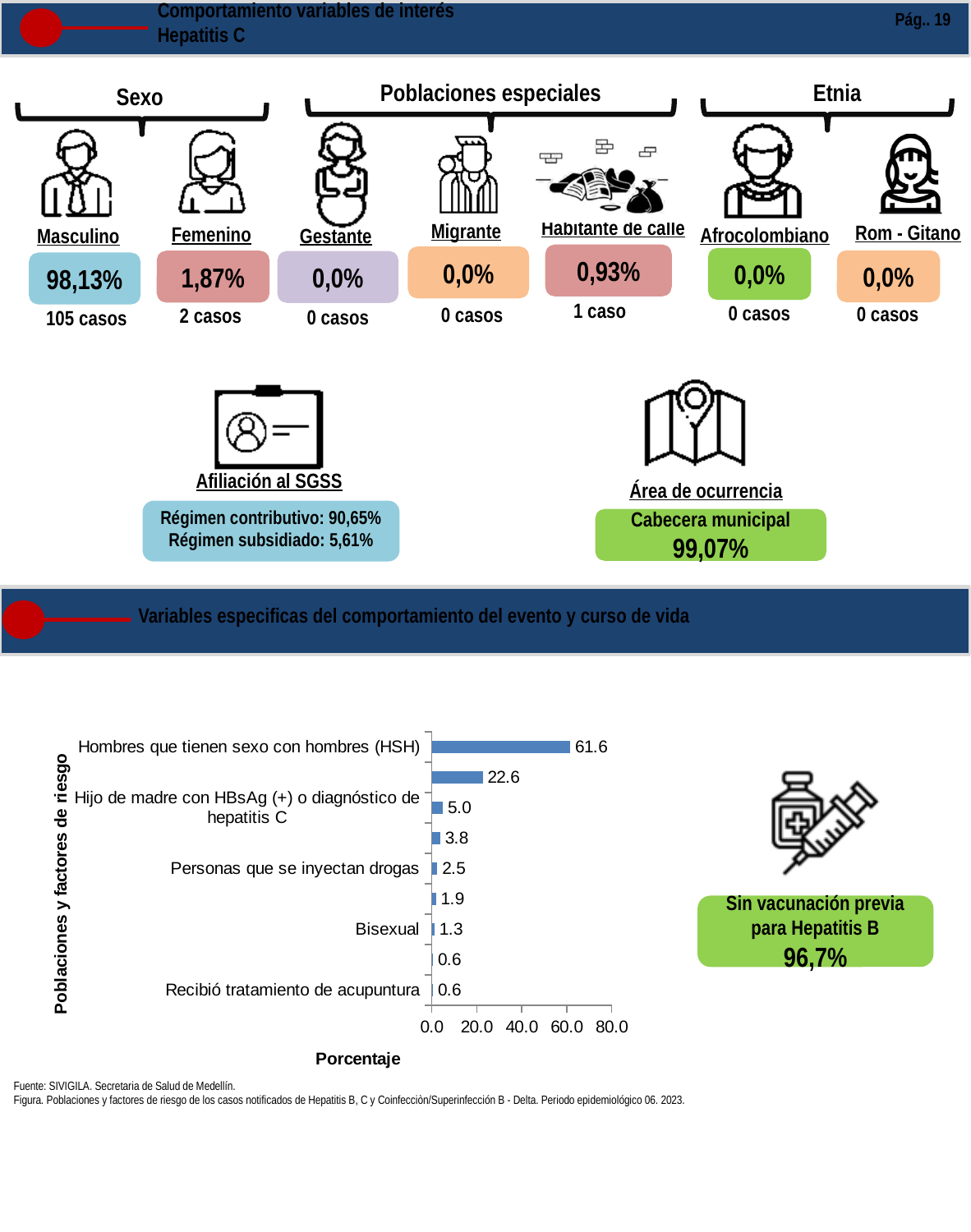
What is the value for Hijo de madre con HBsAg (+) o diagnóstico de hepatitis C in the bar chart? 5.0 Which category has the highest value in the bar chart? Hombres que tienen sexo con hombres (HSH) What is the value for Hombres que tienen sexo con hombres (HSH) in the bar chart? 61.6 What is the value for Bisexual in the bar chart? 1.3 What is the title of the horizontal axis of the bar chart? Porcentaje Is the value for Hombres que tienen sexo con hombres (HSH) greater or less than 40.0? greater What is the difference between the values for Hombres que tienen sexo con hombres (HSH) and Bisexual in the bar chart? 60.3 What is the value for Recibió tratamiento de acupuntura in the bar chart? 0.6 Which is larger in the bar chart: the value for Hijo de madre con HBsAg (+) o diagnóstico de hepatitis C or the value for Personas que se inyectan drogas? Hijo de madre con HBsAg (+) o diagnóstico de hepatitis C What is the value for Personas que se inyectan drogas in the bar chart? 2.5 What kind of chart is shown at the bottom of the slide? bar chart How many bars are plotted in the bar chart? 9